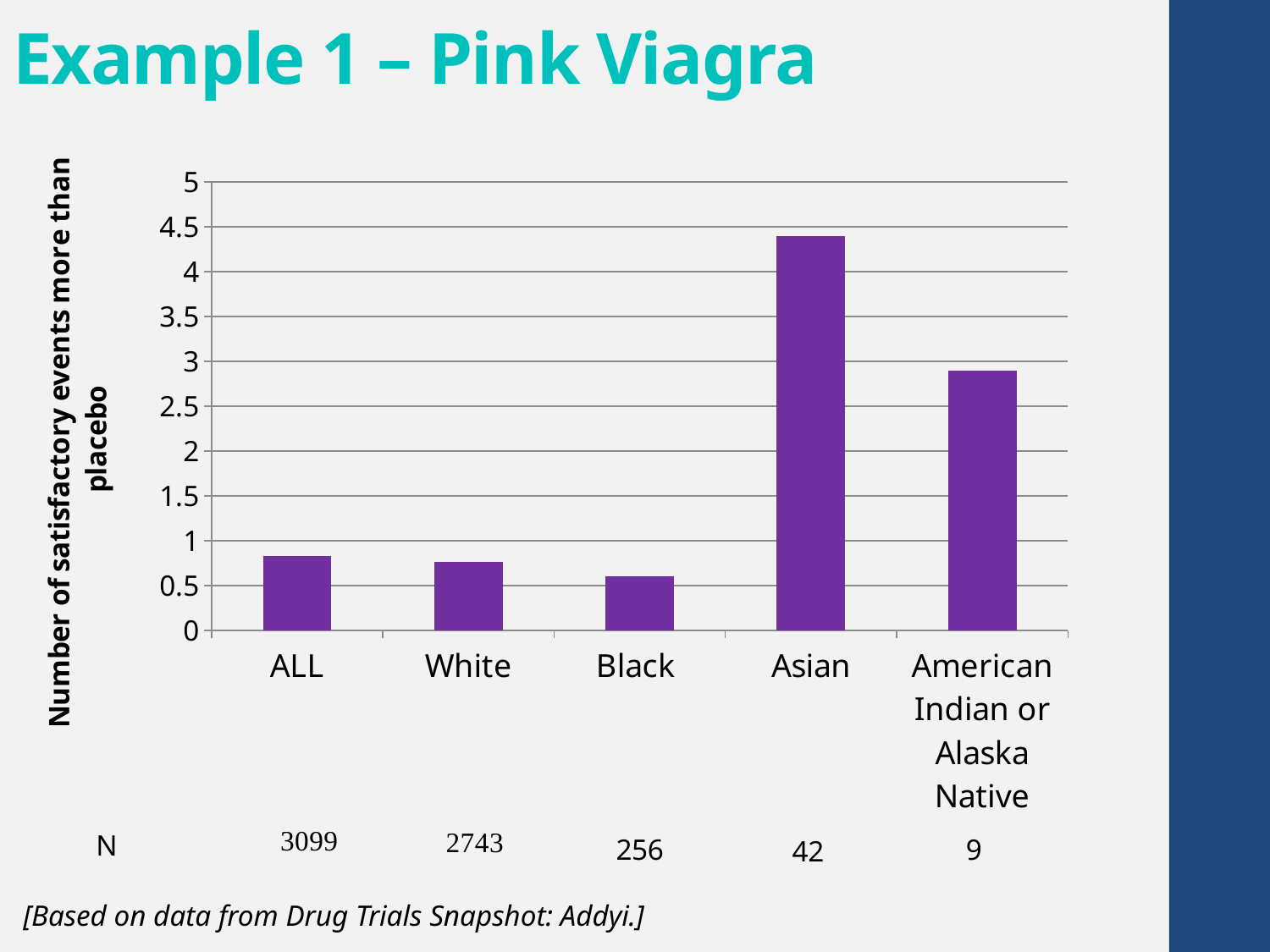
Which is larger, the value for Asian or the value for American Indian or Alaska Native? Asian Which is larger, the value for ALL or the value for Black? ALL How many categories are shown on the x axis of the chart? 5 Is the value for ALL greater or less than 1? less Is the value for White greater or less than 0.5? greater Which category has the lowest bar in the chart? Black What is the title of the vertical axis of the chart? Number of satisfactory events more than placebo What kind of chart is shown on the slide? bar chart Which category has the highest bar in the chart? Asian Is the value for American Indian or Alaska Native greater or less than 2.5? greater